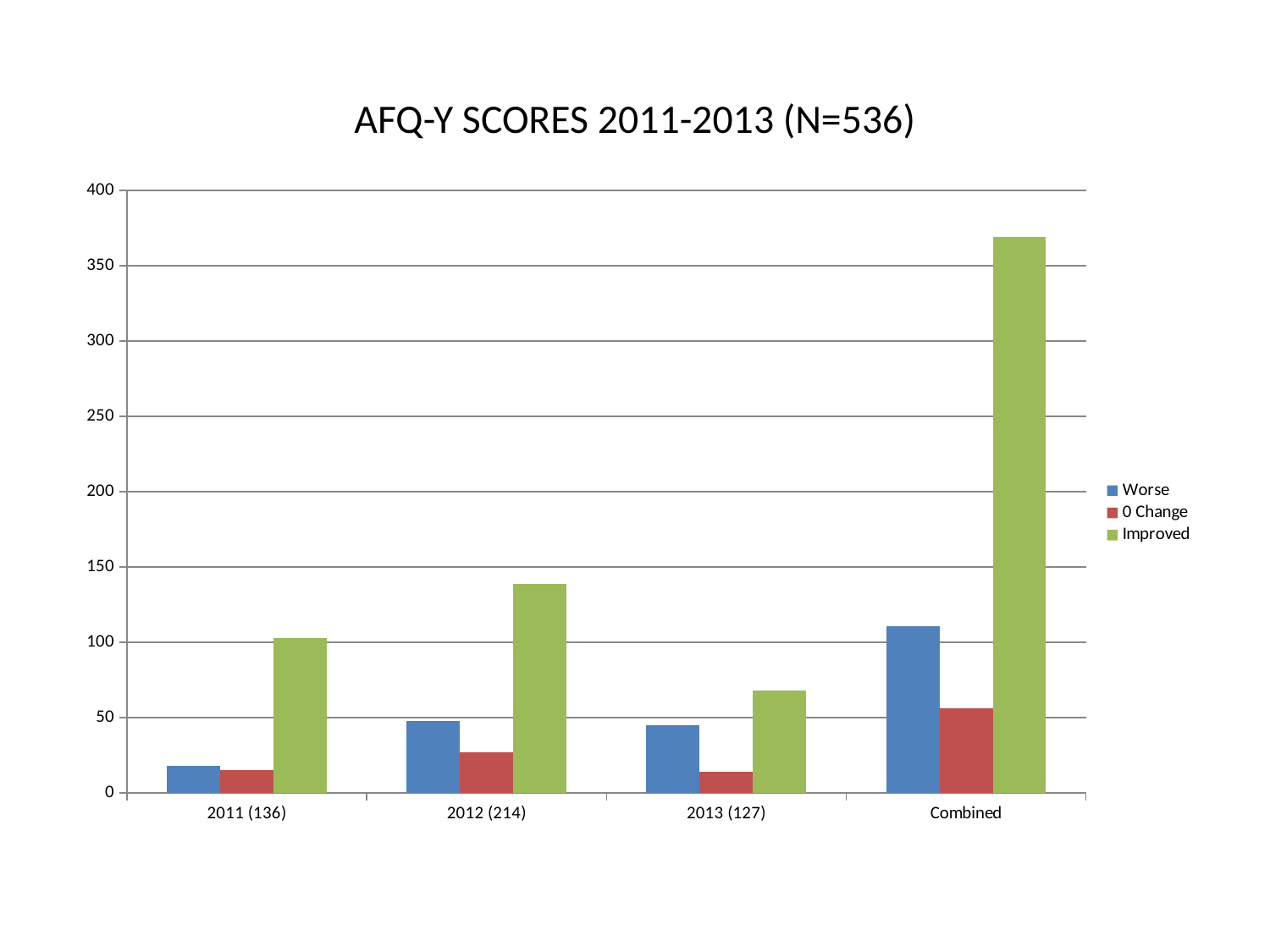
Which series is shown in green in the legend? Improved Is the Worse value for Combined greater or less than 100? greater What is the title of the chart? AFQ-Y SCORES 2011-2013 (N=536) How many series does the legend list? 3 Which is larger, the Improved value for 2012 (214) or for 2013 (127)? 2012 (214) Which category has the highest Improved value? Combined What kind of chart is shown on the slide? bar chart Is the Improved value for Combined greater or less than 350? greater Which category has the lowest Worse value? 2011 (136) Is the Improved value for 2013 (127) greater or less than 100? less How many categories are shown on the x axis? 4